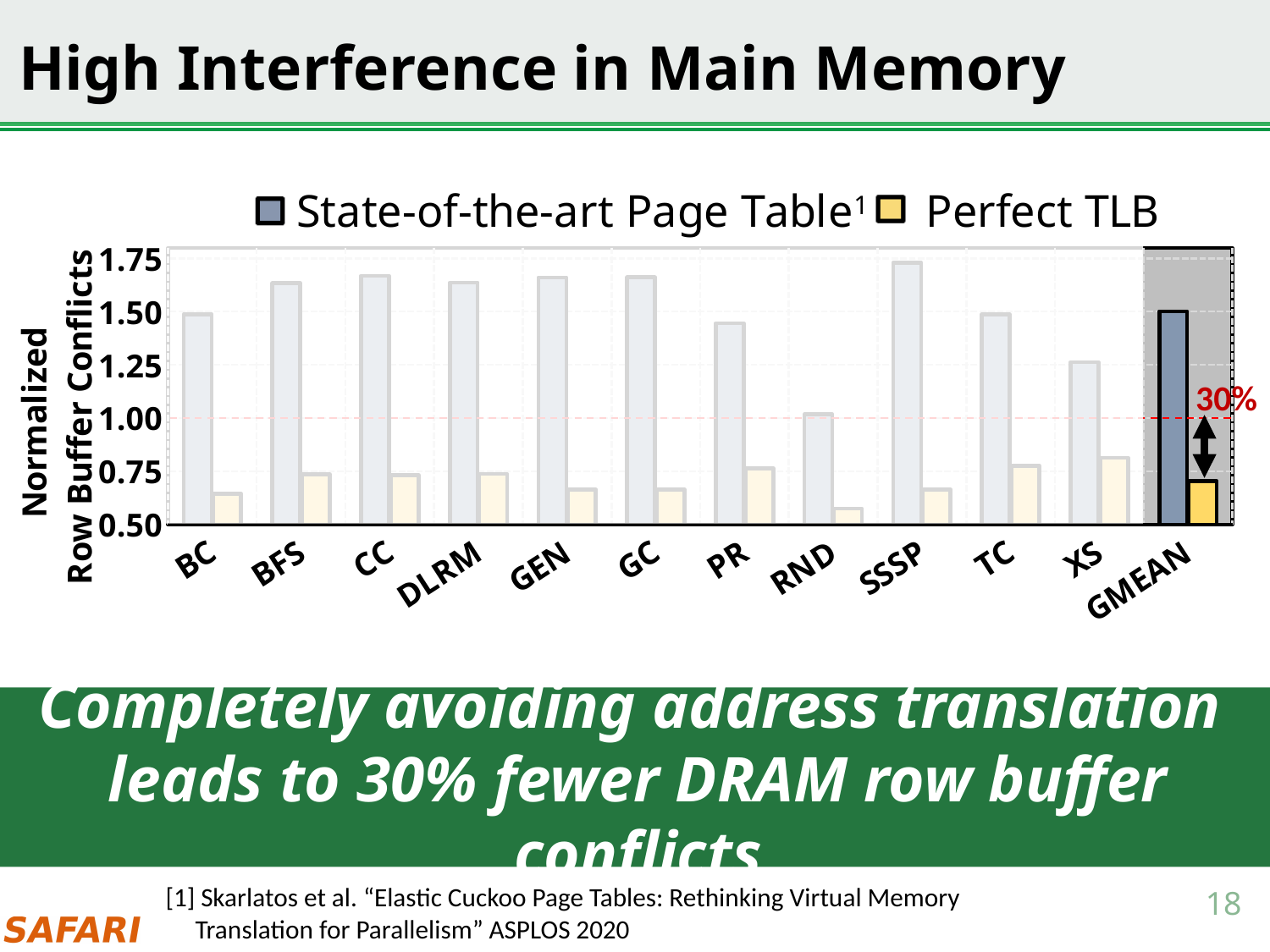
How many categories are shown along the x axis? 12 Is the State-of-the-art Page Table value for GMEAN greater or less than 1.25? greater For BC, which series has the larger value: State-of-the-art Page Table or Perfect TLB? State-of-the-art Page Table Which category has the highest State-of-the-art Page Table value? SSSP How many series does the legend list? 2 Is the Perfect TLB value for RND greater or less than 0.75? less Is the State-of-the-art Page Table value for SSSP greater or less than 1.50? greater What kind of chart is shown on the slide? bar chart What is the label on the y axis of the chart? Normalized Row Buffer Conflicts Which category has the lowest Perfect TLB value? RND Which category has the lowest State-of-the-art Page Table value? RND